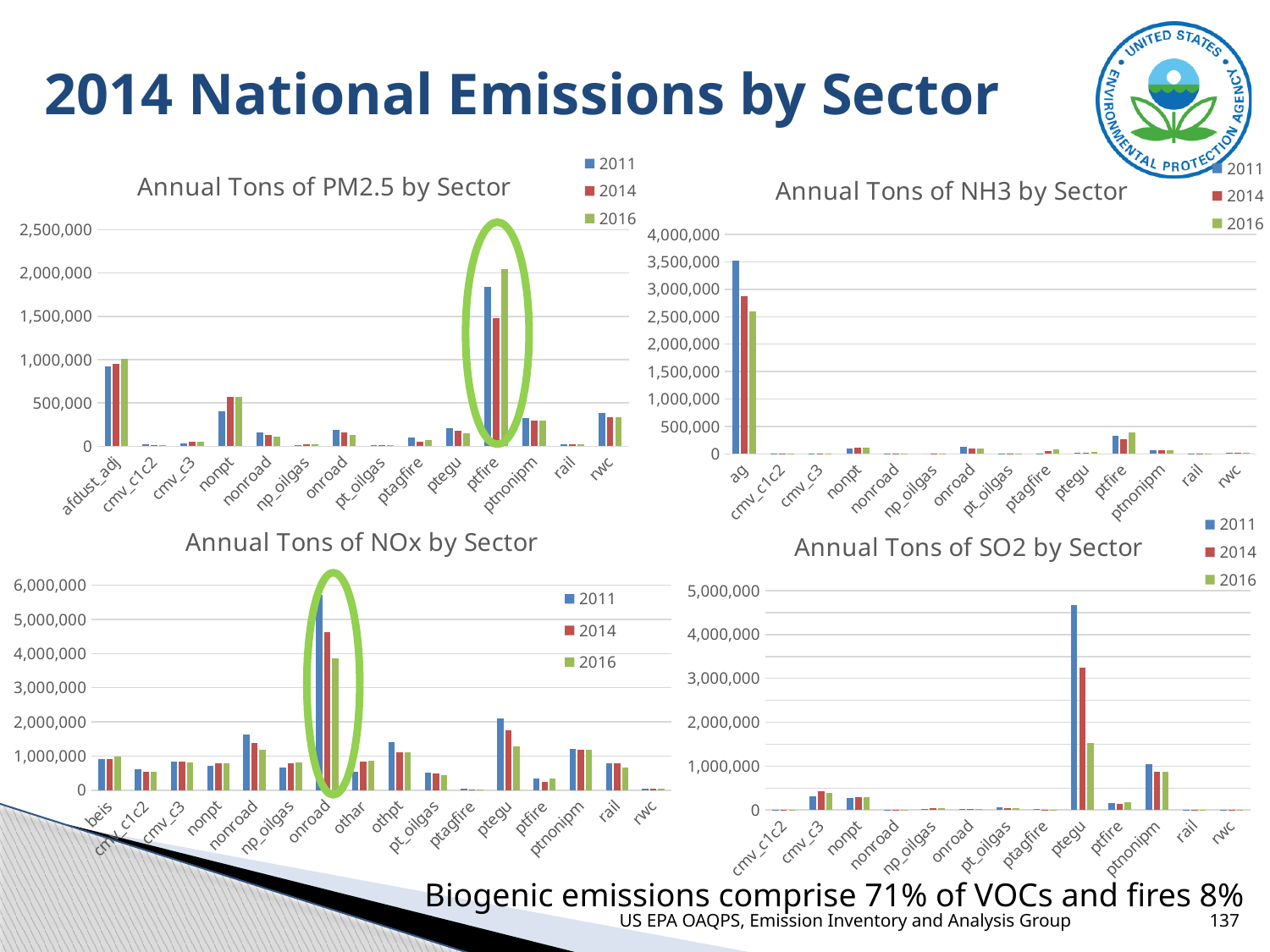
How many charts are shown on the slide? 4 In the "Annual Tons of PM2.5 by Sector" chart, which sector has the highest emissions? ptfire In the "Annual Tons of NOx by Sector" chart, which sector has the highest emissions? onroad In the "Annual Tons of SO2 by Sector" chart, which is larger for ptegu, the 2011 value or the 2014 value? 2011 What type of chart is the "Annual Tons of PM2.5 by Sector" chart? bar chart In the "Annual Tons of NH3 by Sector" chart, which sector has the highest emissions? ag In the "Annual Tons of NH3 by Sector" chart, is the 2011 value for ag greater or less than 3,000,000? greater In the "Annual Tons of PM2.5 by Sector" chart, is the 2011 value for afdust_adj greater or less than 1,000,000? less In the "Annual Tons of NOx by Sector" chart, is the 2011 value for onroad greater or less than 5,000,000? greater In the "Annual Tons of NH3 by Sector" chart, do the ag emissions rise or fall from 2011 to 2016? fall How many series does the legend of the "Annual Tons of NOx by Sector" chart list? 3